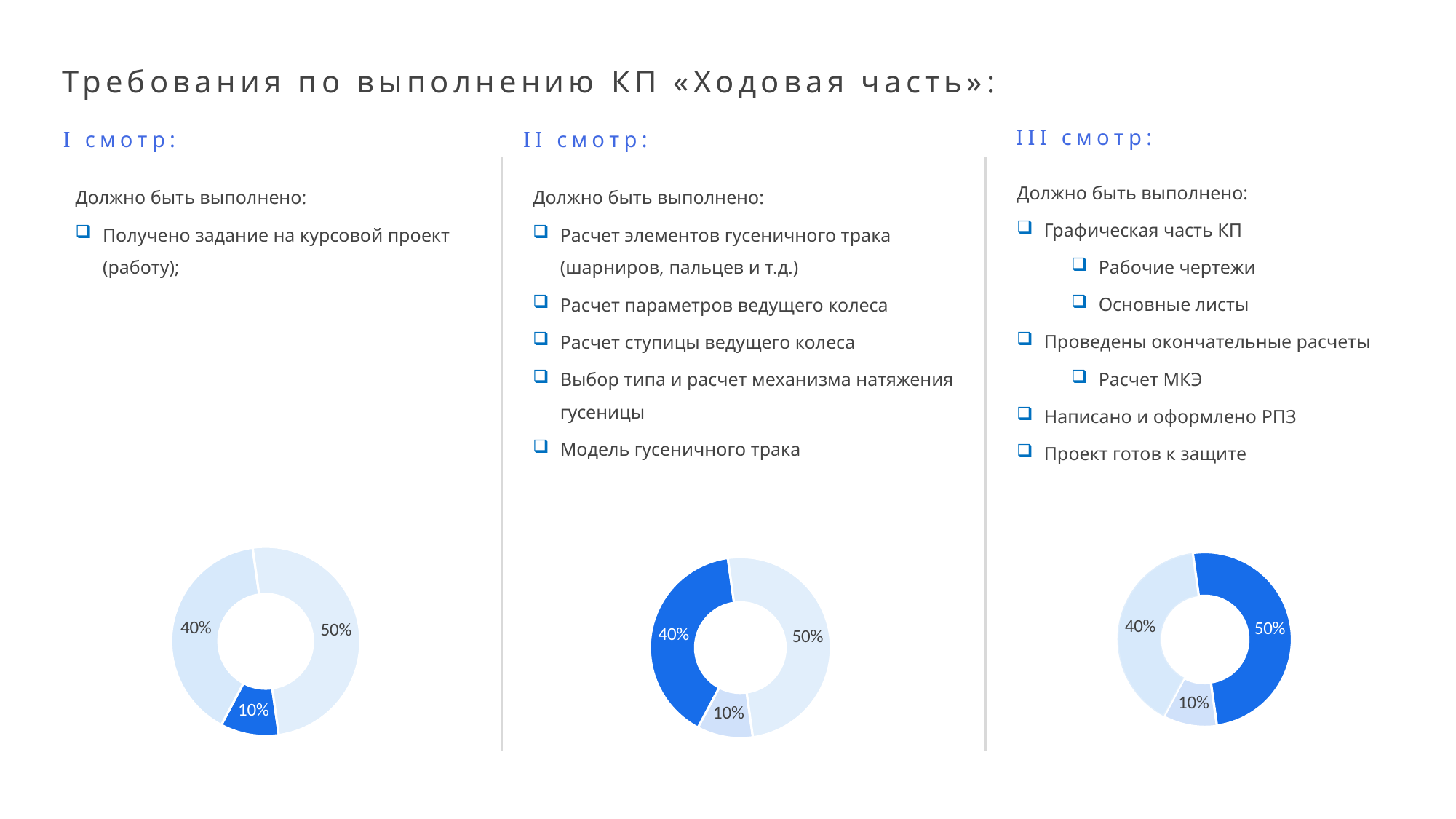
How many slices does the donut chart under "I смотр" have? 3 In the donut chart under "I смотр", what is the value of the largest slice? 50% In the donut chart under "I смотр", which slice is highlighted in dark blue? The 10% slice In the donut chart under "III смотр", what is the value of the smallest slice? 10% How many slices does the donut chart under "III смотр" have? 3 What do the three slices of the donut chart under "I смотр" add up to? 100% In the donut chart under "II смотр", which is larger: the 40% slice or the 10% slice? The 40% slice In the donut chart under "III смотр", what is the difference between the 50% slice and the 40% slice? 10% In the donut chart under "III смотр", which slice is highlighted in dark blue? The 50% slice In the donut chart under "I смотр", what is the value of the smallest slice? 10% What kind of chart is shown under "I смотр" at the bottom left of the slide? Donut (pie) chart In the donut chart under "II смотр", what is the difference between the largest and smallest slice values? 40%